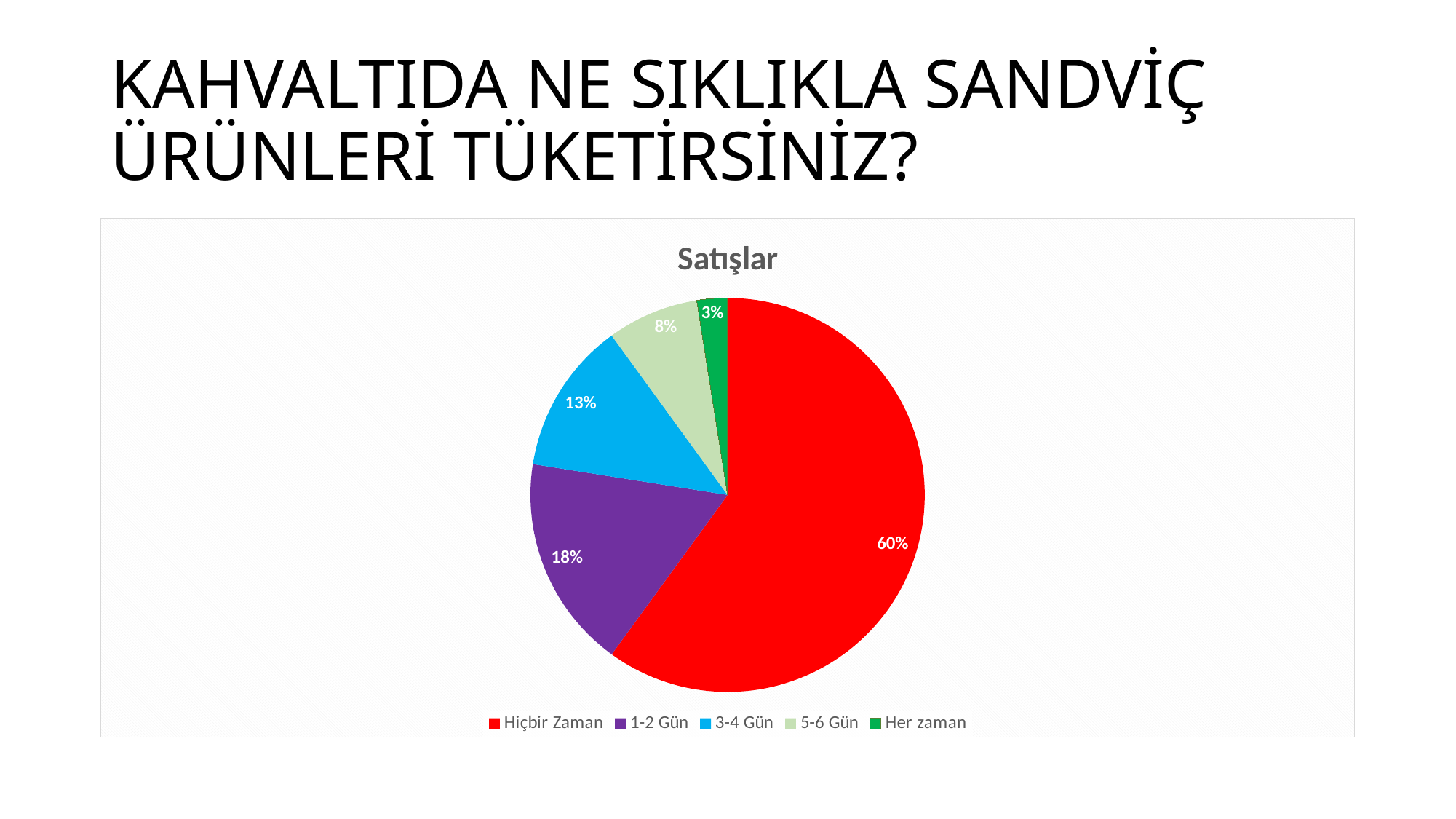
What is the difference between the values for 1-2 Gün and 3-4 Gün? 5% What kind of chart is shown on the slide? pie chart Which category has the largest slice? Hiçbir Zaman How many categories does the legend list? 5 Which category has the smallest slice? Her zaman What share of the pie does Hiçbir Zaman take? 60% What is the value for 5-6 Gün? 8% What is the value for Her zaman? 3% Which is larger, the value for 5-6 Gün or the value for 3-4 Gün? 3-4 Gün What is the chart's title? Satışlar What is the value for 1-2 Gün? 18% What is the value for 3-4 Gün? 13%